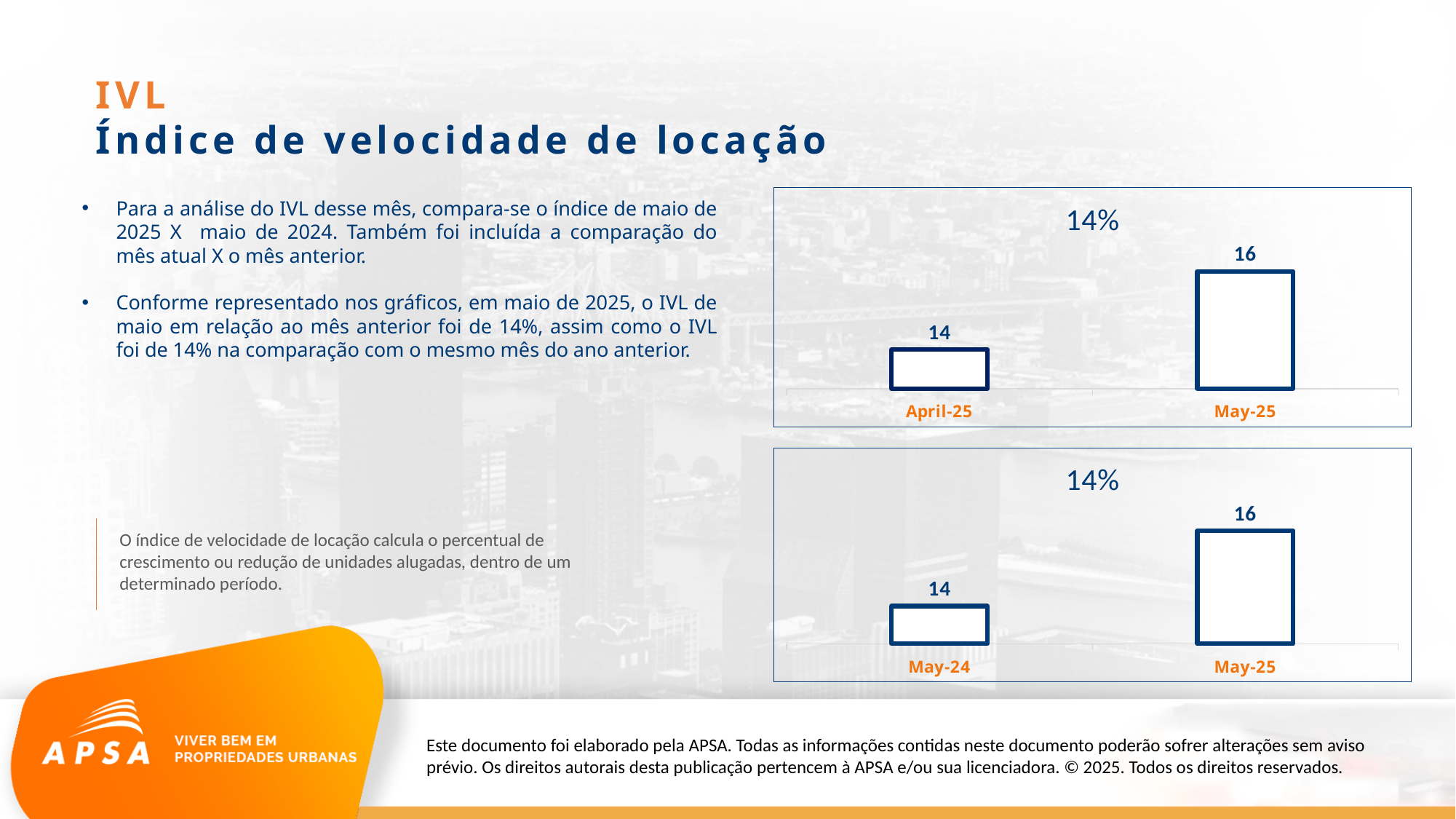
In the bottom chart, what is the value for May-24? 14 In the bottom chart, do the values rise or fall from May-24 to May-25? Rise In the top chart, which category has the highest value? May-25 In the top chart, what is the value for May-25? 16 How many categories does the top chart show? 2 In the top chart, what is the difference between the values for May-25 and April-25? 2 In the bottom chart, what is the value for May-25? 16 In the bottom chart, which category has the lowest value? May-24 What percentage is printed at the top of the top chart? 14% In the bottom chart, which is larger, the value for May-24 or May-25? May-25 What kind of chart is the bottom chart? Bar chart In the top chart, what is the value for April-25? 14